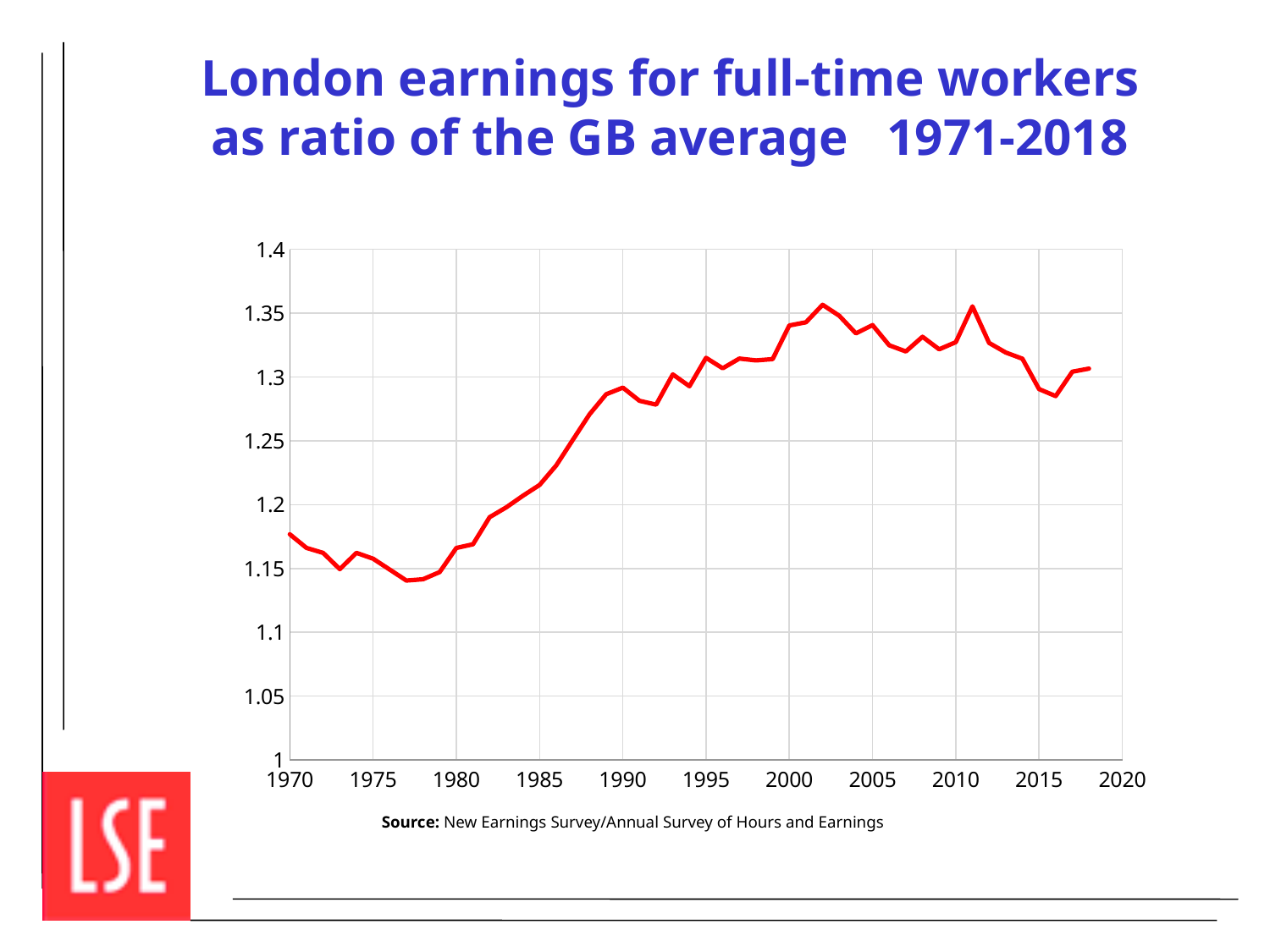
How many lines are plotted on the chart? 1 Does the ratio rise or fall between 1970 and 1977? fall Is the value for 2015 greater or less than 1.3? less What source is cited below the chart? New Earnings Survey/Annual Survey of Hours and Earnings Does the ratio rise or fall between 1980 and 1990? rise Is the value for 2000 greater or less than 1.3? greater What is the title of the chart? London earnings for full-time workers as ratio of the GB average 1971-2018 Which year has the larger value, 1980 or 2000? 2000 Is the value for 1985 greater or less than 1.2? greater What kind of chart is shown on the slide? line chart